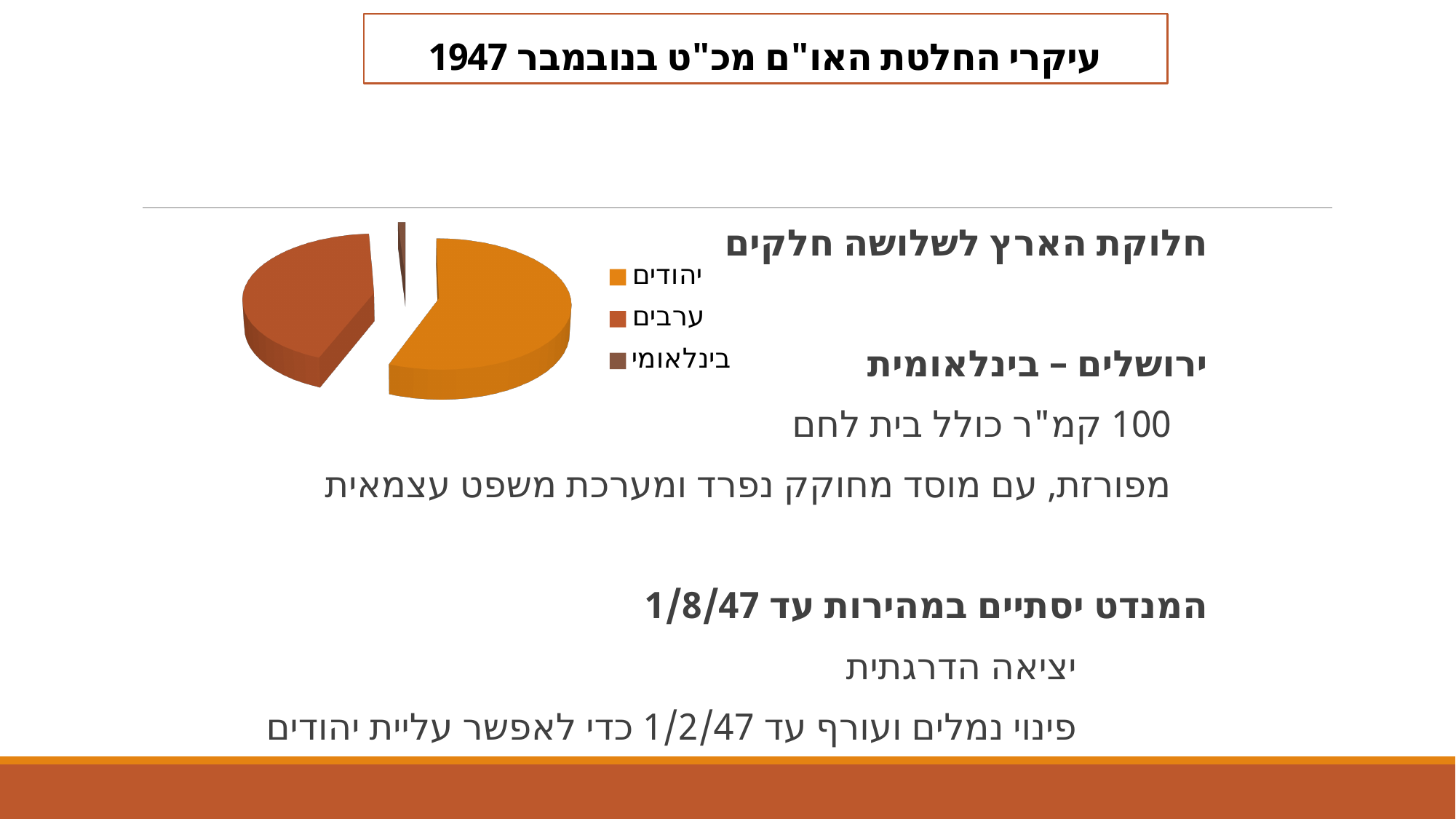
Which slice is larger in the pie chart, יהודים or ערבים? יהודים How many entries does the legend of the pie chart list? 3 How many slices does the pie chart have? 3 What colour is the יהודים slice in the pie chart? Orange Which category has the smallest slice in the pie chart? בינלאומי What kind of chart is shown on the slide? Pie chart Which legend entry is shown in dark brown in the pie chart? בינלאומי Which category has the largest slice in the pie chart? יהודים Which slice is larger in the pie chart, ערבים or בינלאומי? ערבים